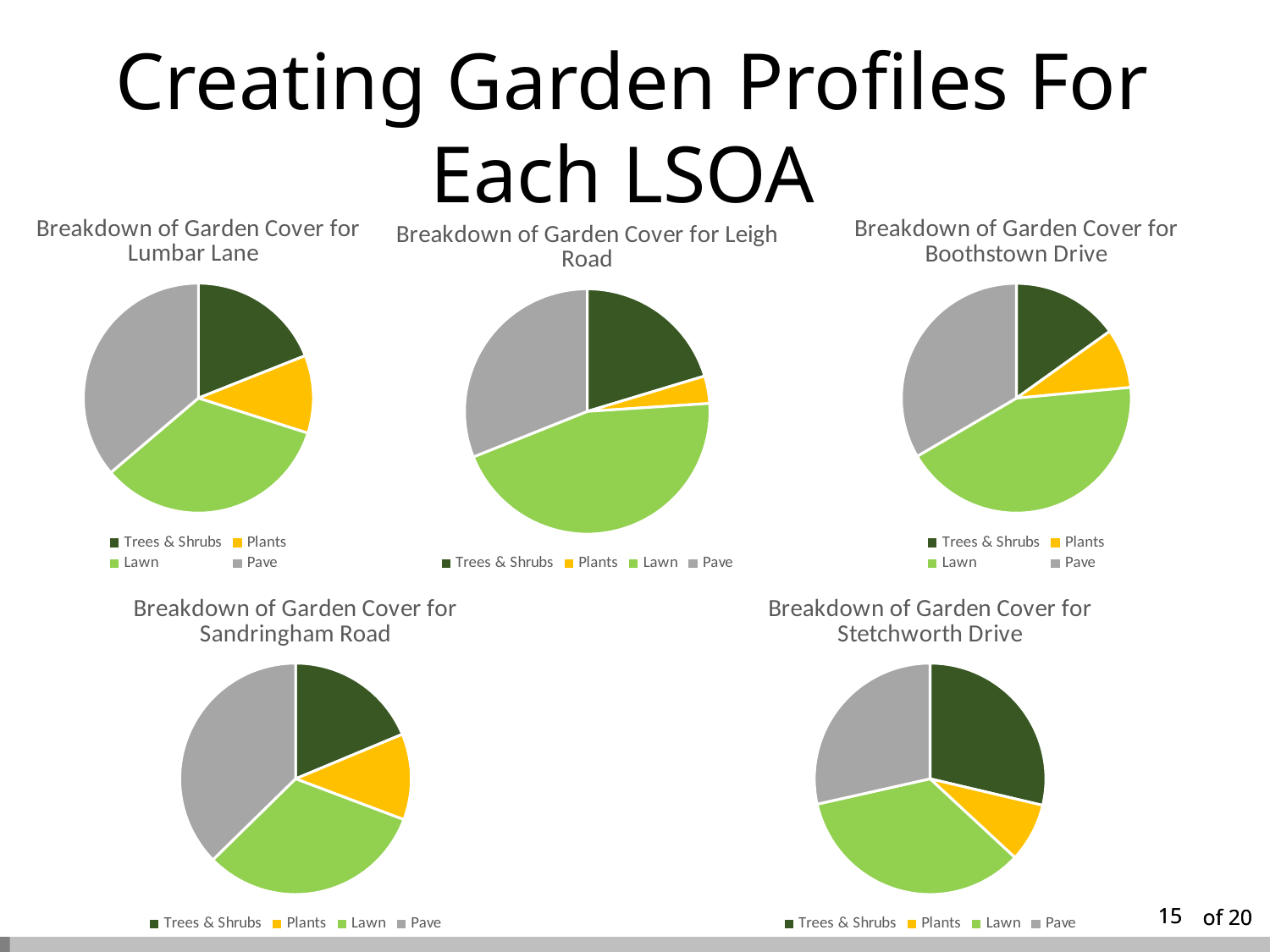
In the 'Breakdown of Garden Cover for Leigh Road' chart, which category has the smallest slice? Plants In the 'Breakdown of Garden Cover for Boothstown Drive' chart, which category has the largest slice? Lawn In the 'Breakdown of Garden Cover for Leigh Road' chart, which category has the largest slice? Lawn In the 'Breakdown of Garden Cover for Lumbar Lane' chart, which category has the largest slice? Pave In the 'Breakdown of Garden Cover for Leigh Road' chart, which is larger, the Lawn slice or the Pave slice? Lawn What kind of chart is the 'Breakdown of Garden Cover for Lumbar Lane' chart? pie chart In the 'Breakdown of Garden Cover for Leigh Road' chart, how many slices does the pie have? 4 In the 'Breakdown of Garden Cover for Stetchworth Drive' chart, which category has the smallest slice? Plants How many pie charts are shown on the slide? 5 How many entries does the legend of the 'Breakdown of Garden Cover for Boothstown Drive' chart list? 4 In the 'Breakdown of Garden Cover for Lumbar Lane' chart, which category has the smallest slice? Plants